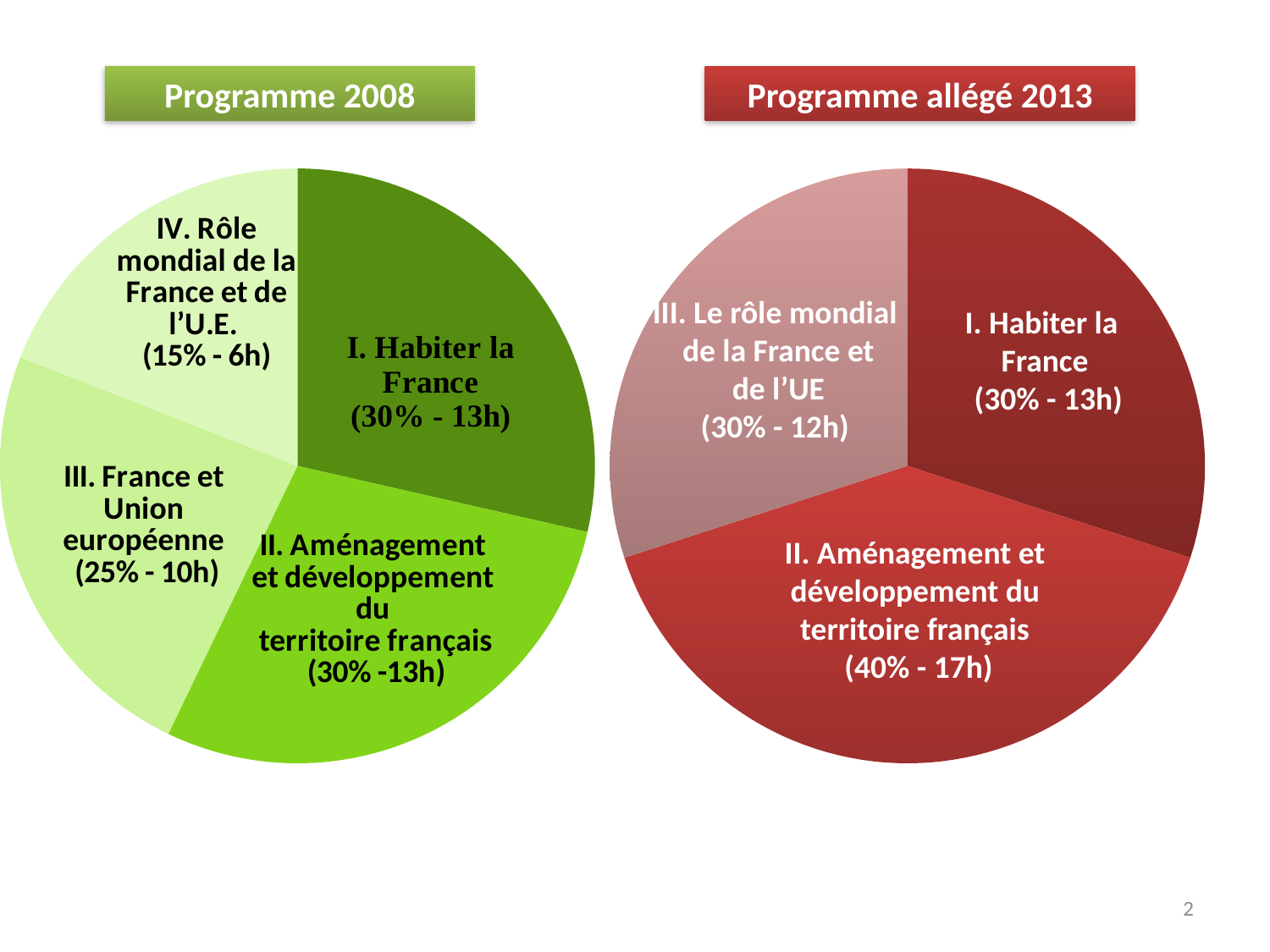
What is the title of the chart on the right side of the slide? Programme allégé 2013 In the Programme 2008 chart, what share and hours are shown for 'III. France et Union européenne'? 25% - 10h How many slices does the Programme allégé 2013 pie chart have? 3 In the Programme 2008 chart, what is the difference in hours between 'III. France et Union européenne' and 'IV. Rôle mondial de la France et de l'U.E.'? 4h In the Programme allégé 2013 chart, what share and hours are shown for 'II. Aménagement et développement du territoire français'? 40% - 17h How many slices does the Programme 2008 pie chart have? 4 Which has more hours: 'II. Aménagement et développement du territoire français' in Programme 2008 or in Programme allégé 2013? Programme allégé 2013 In the Programme allégé 2013 chart, how many hours are allocated to 'III. Le rôle mondial de la France et de l'UE'? 12h In the Programme 2008 chart, what share and hours are shown for 'IV. Rôle mondial de la France et de l'U.E.'? 15% - 6h What kind of chart is used for the Programme 2008 data? Pie chart In the Programme allégé 2013 chart, which slice has the largest share? II. Aménagement et développement du territoire français In the Programme 2008 chart, which slice has the smallest share? IV. Rôle mondial de la France et de l'U.E.